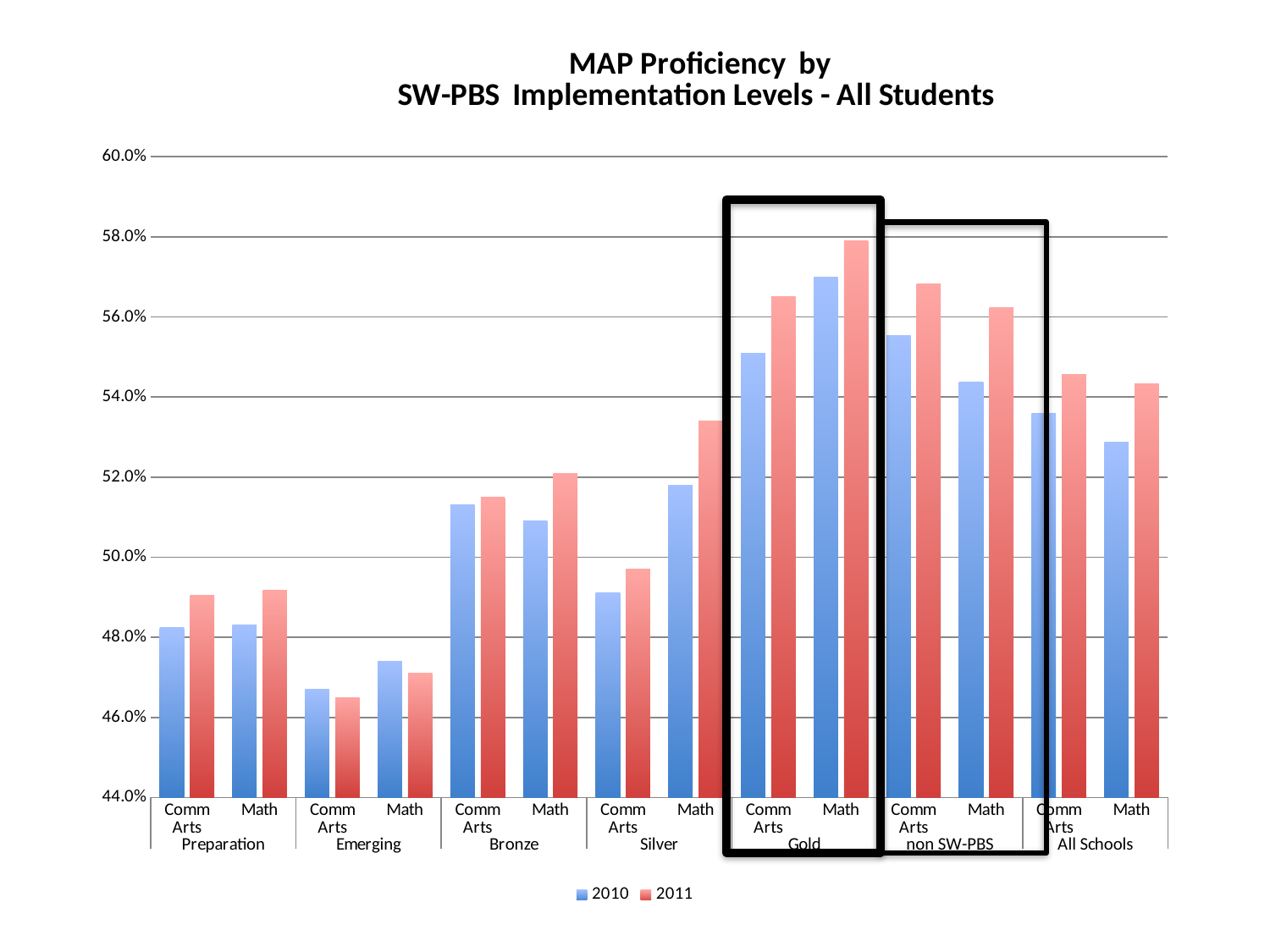
Which is larger for Preparation Comm Arts, the 2010 value or the 2011 value? 2011 What is the title of the chart? MAP Proficiency by SW-PBS Implementation Levels - All Students How many implementation level groups are shown along the x axis? 7 Is the 2010 Comm Arts value for Emerging greater or less than 48.0%? less Which is larger, the 2011 Math value for Gold or the 2011 Math value for non SW-PBS? Gold What kind of chart is shown on the slide? Bar chart Which implementation level has the highest bar on the chart? Gold Is the 2011 Math value for Gold greater or less than 56.0%? greater Is the 2011 Math value for Silver greater or less than 52.0%? greater Which colour represents the 2011 series in the legend? Red Which implementation level has the lowest bars on the chart? Emerging How many series does the legend list? 2